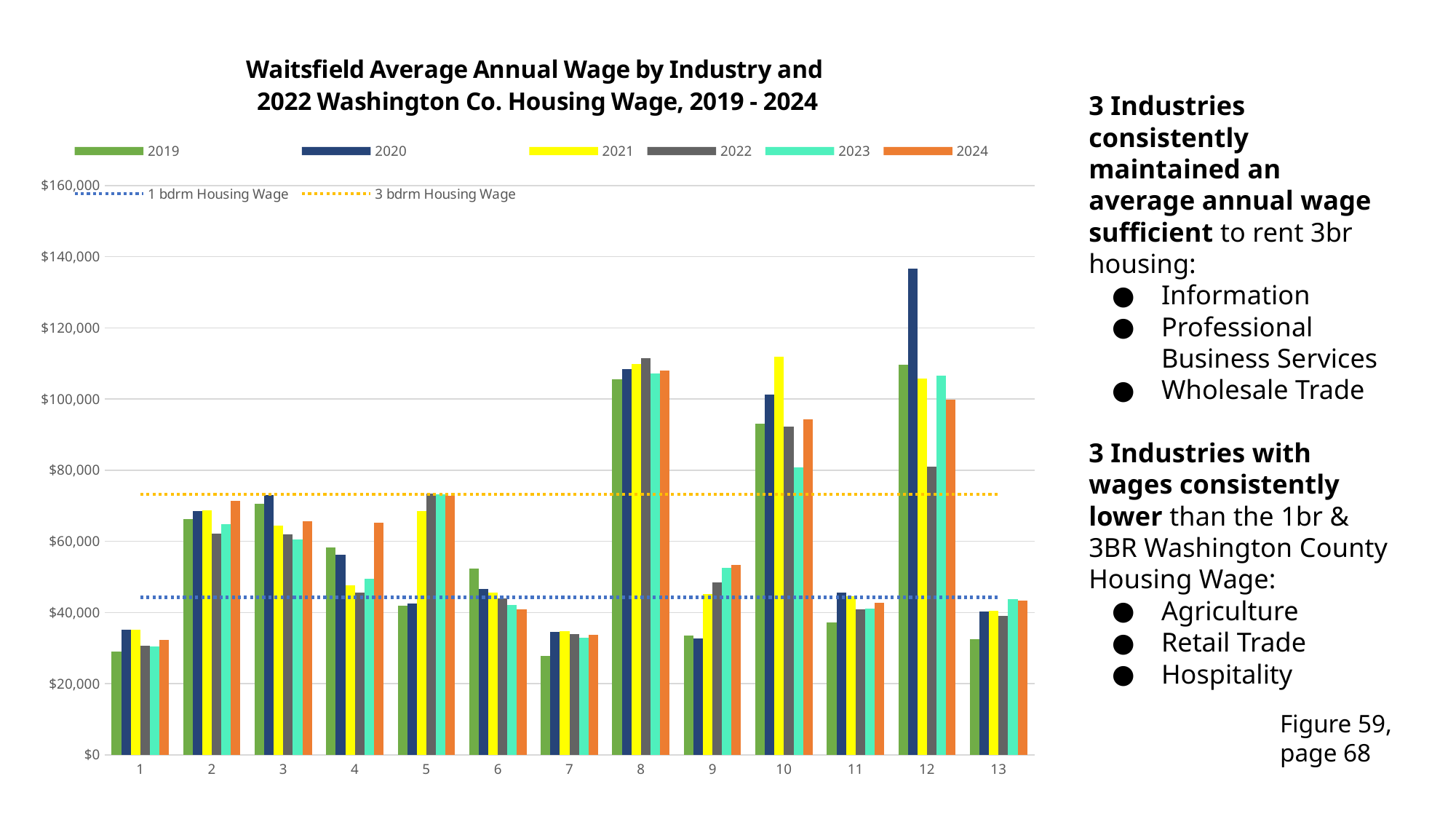
What kind of chart is shown on the slide? bar chart Which two dotted reference lines are shown in the legend? 1 bdrm Housing Wage and 3 bdrm Housing Wage What is the title of the chart? Waitsfield Average Annual Wage by Industry and 2022 Washington Co. Housing Wage, 2019 - 2024 How many numbered categories are shown on the x axis? 13 For category 12, which is larger: the 2020 value or the 2022 value? 2020 Is the 2020 value for category 12 greater or less than $120,000? greater Which is larger: the 2019 value for category 8 or the 2019 value for category 1? category 8 Is the 2019 value for category 1 greater or less than $40,000? less Which category has the highest 2020 value? 12 Is the 2024 value for category 7 greater or less than $40,000? less How many years does the legend list as bar series? 6